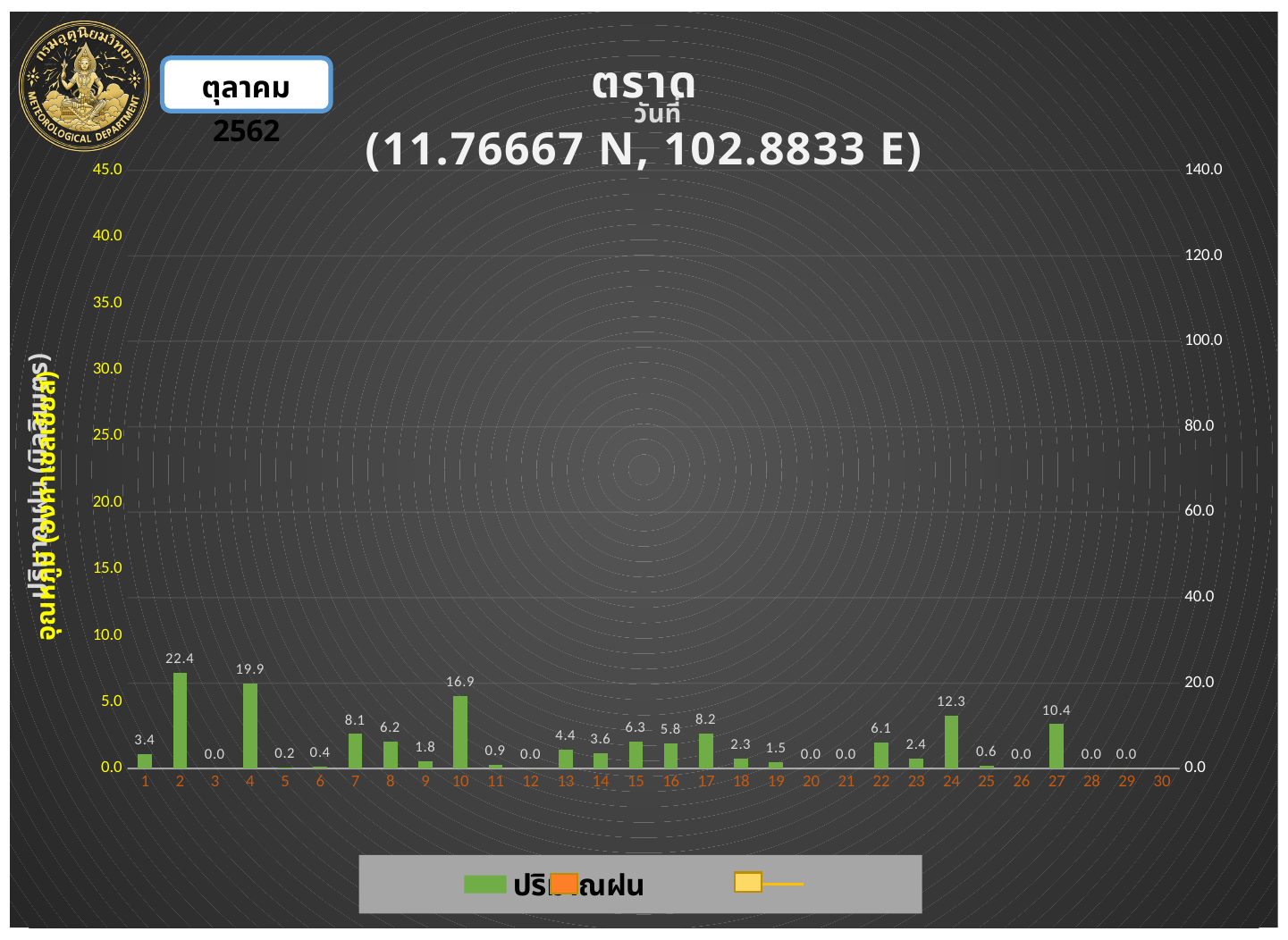
What is the rainfall value shown for day 24? 12.3 What is the rainfall value shown for day 27? 10.4 What is the station name shown in the chart title? ตราด What is the difference between the rainfall values for day 2 and day 4? 2.5 What is the rainfall value shown for day 10? 16.9 Which day has the highest rainfall value? 2 Which has a larger rainfall value, day 7 or day 17? day 17 Which has a larger rainfall value, day 15 or day 22? day 15 What is the difference between the rainfall values for day 10 and day 24? 4.6 What is the rainfall value shown for day 2? 22.4 How many days are shown on the x axis? 30 What kind of chart is shown on the slide? bar chart